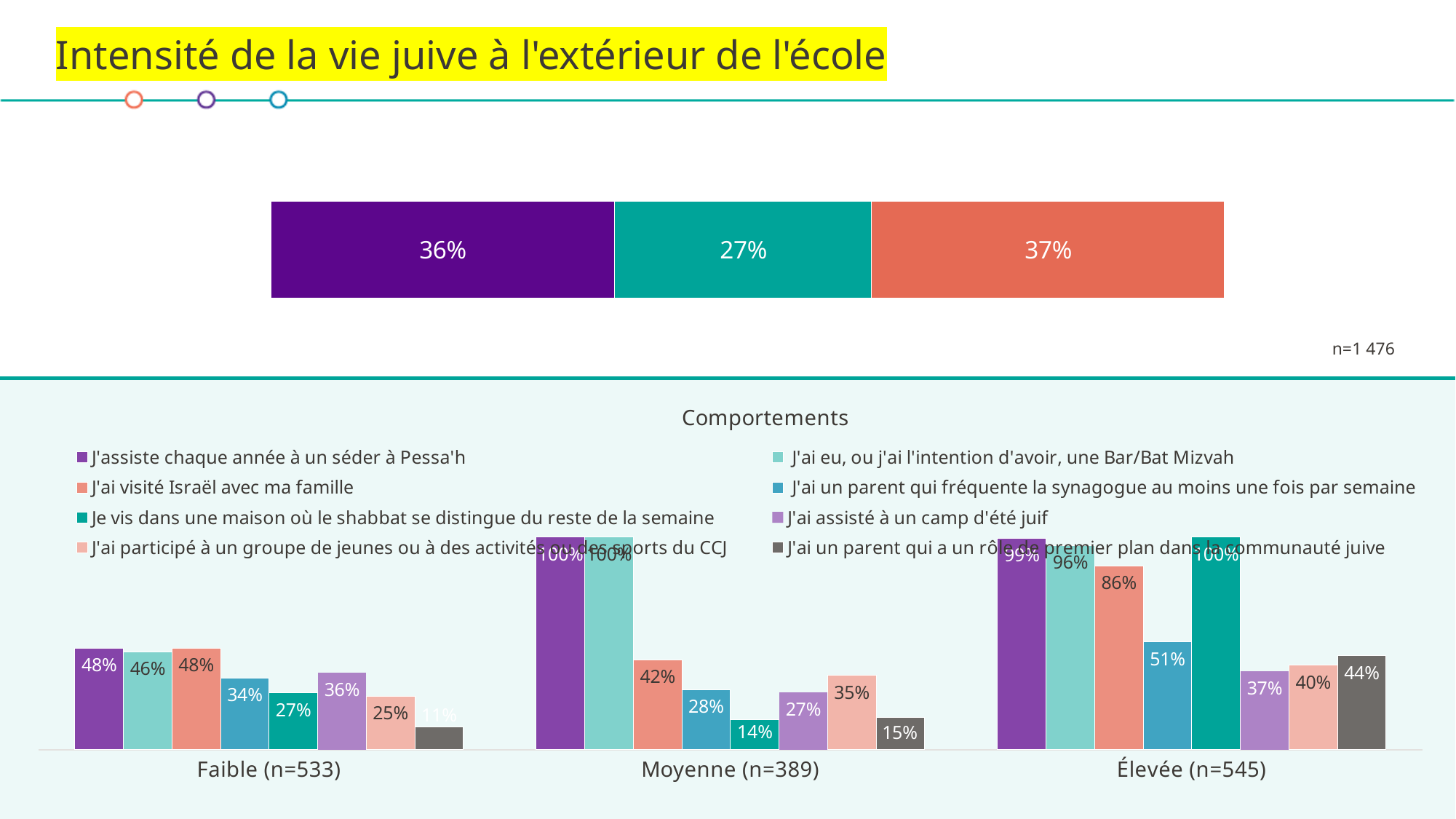
In the stacked bar at the top of the slide, what is the value of the middle (teal) segment? 27% How many series does the legend of the 'Comportements' chart list? 8 In the 'Comportements' chart, what is the value for 'J'ai un parent qui fréquente la synagogue au moins une fois par semaine' in the 'Faible (n=533)' group? 34% In the 'Comportements' chart, what is the value for 'J'ai visité Israël avec ma famille' in the 'Élevée (n=545)' group? 86% How many category groups are shown on the x axis of the 'Comportements' chart? 3 In the 'Comportements' chart, what is the difference between the 'Élevée (n=545)' and 'Faible (n=533)' values for 'J'ai visité Israël avec ma famille'? 38% In the stacked bar at the top of the slide, what is the total of the three segments? 100% In the 'Comportements' chart, which series has the highest value in the 'Élevée (n=545)' group? Je vis dans une maison où le shabbat se distingue du reste de la semaine What kind of chart is the 'Comportements' chart? Bar chart In the 'Comportements' chart, which is larger for 'J'ai assisté à un camp d'été juif': the 'Faible (n=533)' value or the 'Moyenne (n=389)' value? Faible (n=533) In the 'Comportements' chart, what is the value for 'Je vis dans une maison où le shabbat se distingue du reste de la semaine' in the 'Moyenne (n=389)' group? 14% In the 'Comportements' chart, which series has the lowest value in the 'Faible (n=533)' group? J'ai un parent qui a un rôle de premier plan dans la communauté juive